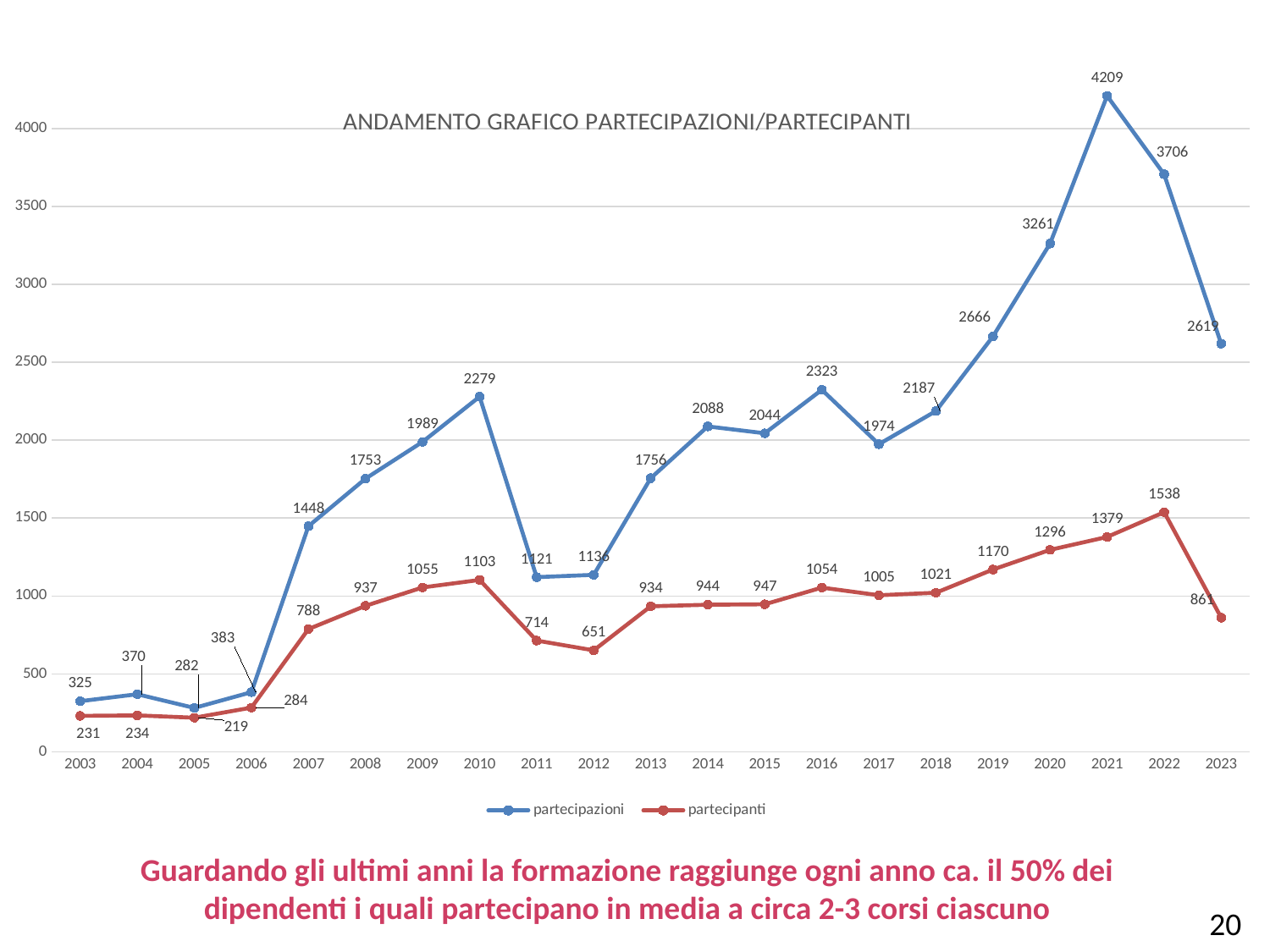
In which year is partecipanti lowest? 2005 How many series does the legend list? 2 Which is larger: partecipazioni in 2016 or partecipazioni in 2018? partecipazioni in 2016 Does partecipazioni rise or fall from 2021 to 2023? Fall What is the value of partecipanti in 2022? 1538 What is the value of partecipazioni in 2010? 2279 What is the value of partecipazioni in 2021? 4209 In which year is partecipazioni highest? 2021 What type of chart is shown on the slide? Line chart What is the title of the chart? ANDAMENTO GRAFICO PARTECIPAZIONI/PARTECIPANTI How many years are plotted on the x axis? 21 What is the difference between partecipazioni and partecipanti in 2023? 1758